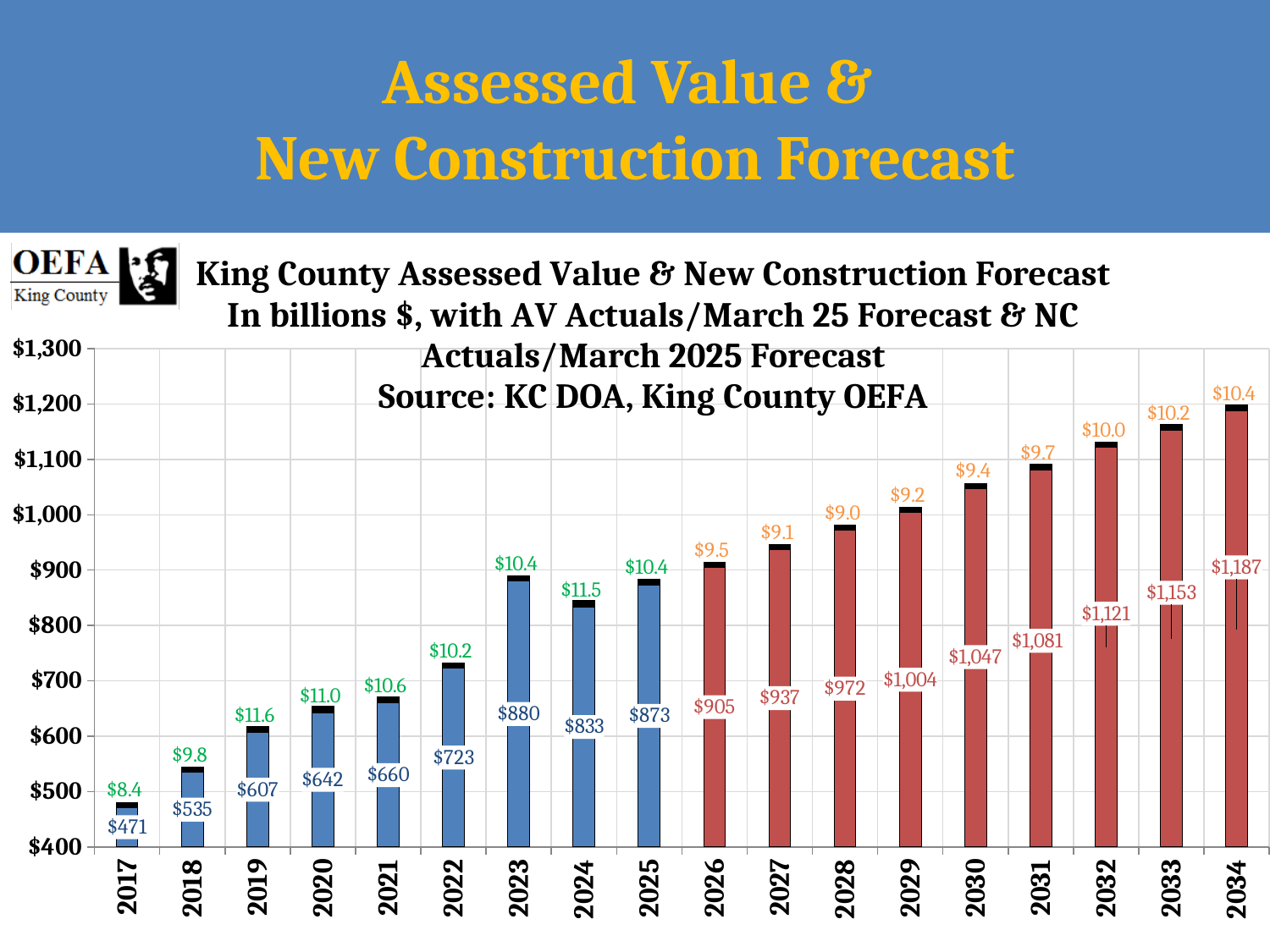
Which year has the larger assessed value, 2023 or 2024? 2023 What is the new construction label shown above the 2024 bar? $11.5 What is the assessed value label for 2017? $471 What is the difference between the assessed value for 2025 and the assessed value for 2024? $40 Do the assessed values rise or fall from 2026 to 2034? Rise What is the assessed value label for 2034? $1,187 What is the new construction label shown above the 2019 bar? $11.6 Which year has the highest assessed value? 2034 Which year has the lowest new construction value? 2017 What is the difference between the assessed value for 2034 and the assessed value for 2017? $716 How many years are shown on the x axis? 18 What kind of chart is shown on the slide? Bar chart